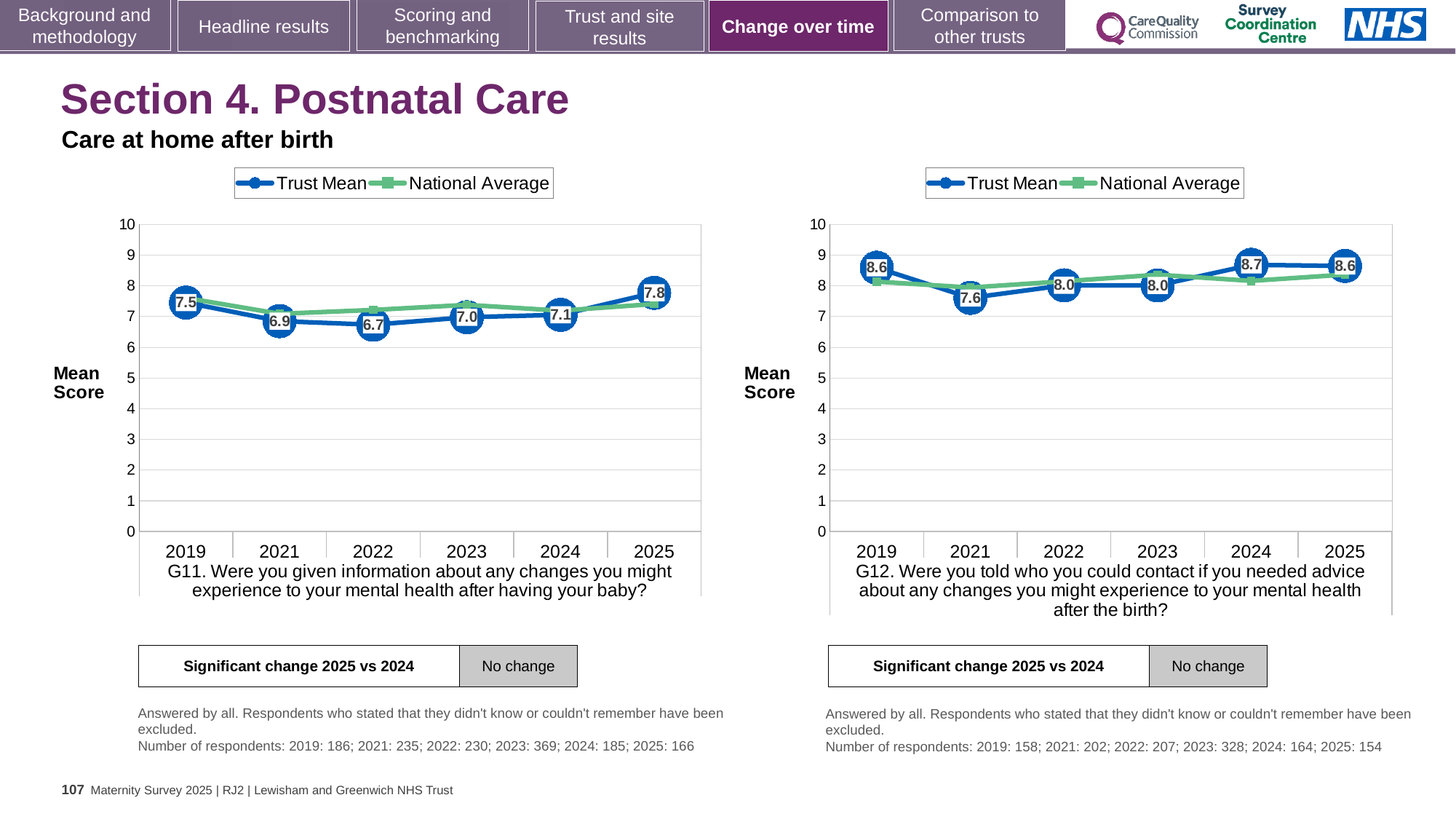
In the G11 chart on the left, which year has the larger Trust Mean score, 2019 or 2023? 2019 In the G11 chart on the left, what is the difference between the Trust Mean scores for 2025 and 2024? 0.7 In the G12 chart on the right, what is the difference between the Trust Mean scores for 2019 and 2021? 1.0 How many series does the legend of the G11 chart on the left list? 2 In the G11 chart on the left, does the Trust Mean score rise or fall from 2022 to 2025? Rise In the G11 chart on the left, which year has the highest Trust Mean score? 2025 In the G12 chart on the right, what is the Trust Mean score for 2024? 8.7 In the G11 chart on the left, is the National Average value for 2019 greater or less than 7? greater In the G12 chart on the right, which year has the lowest Trust Mean score? 2021 What kind of chart is the G12 chart on the right? Line chart In the G11 chart on the left, what is the Trust Mean score for 2022? 6.7 How many years are plotted on the x axis of the G12 chart on the right? 6